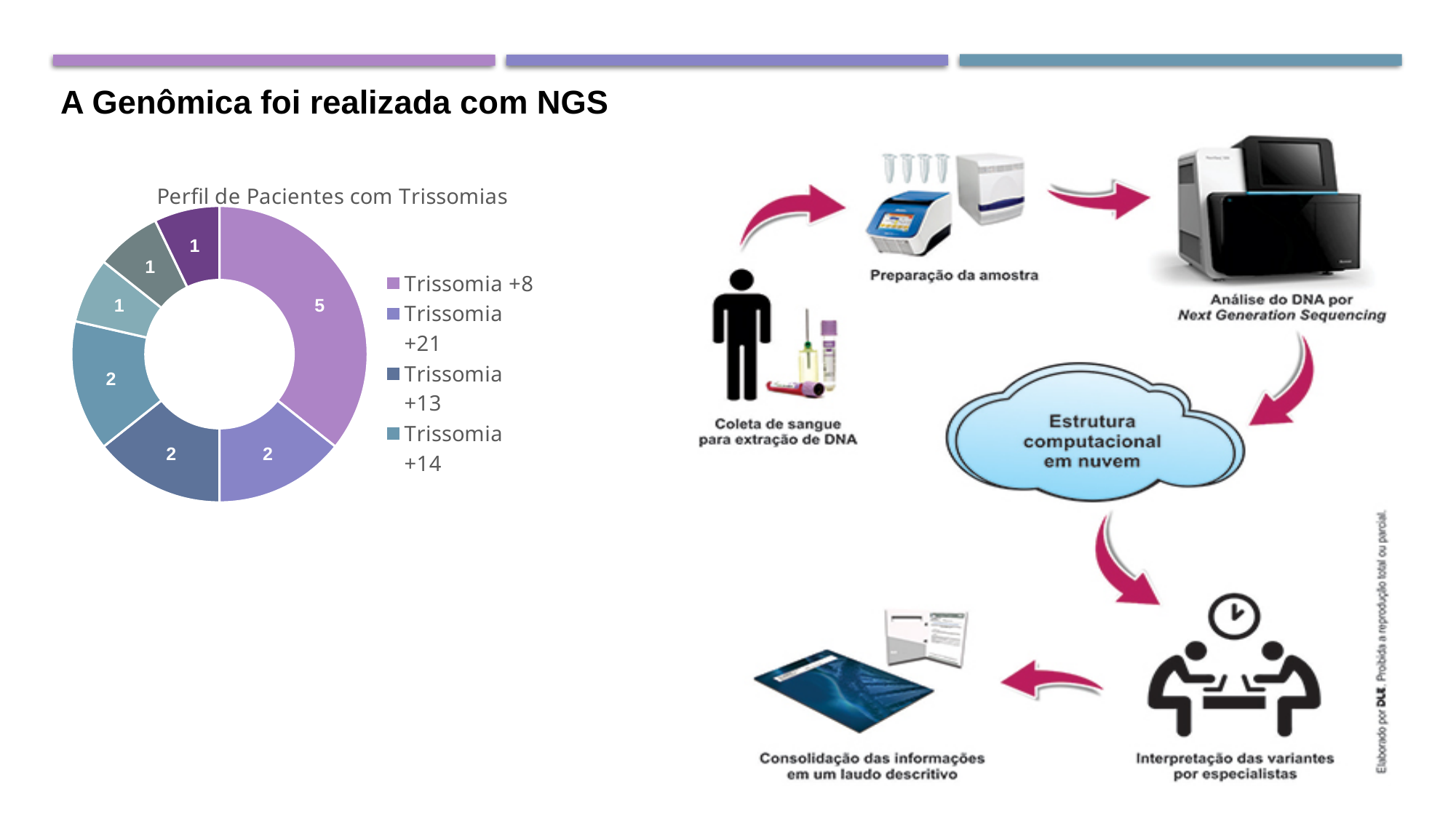
What is the value for Trissomia +21 in the chart? 2 What kind of chart is shown on the slide? Doughnut (pie) chart What is the total of all the slice values shown in the chart? 14 Which category has the largest slice in the chart? Trissomia +8 How many slices does the doughnut chart have? 7 What is the value for Trissomia +8 in the chart? 5 What is the value for Trissomia +13 in the chart? 2 What is the difference between the values for Trissomia +8 and Trissomia +21? 3 What is the value for Trissomia +14 in the chart? 2 Which is larger, the value for Trissomia +8 or the value for Trissomia +13? Trissomia +8 What is the title of the chart on the slide? Perfil de Pacientes com Trissomias How many entries does the chart legend list? 4